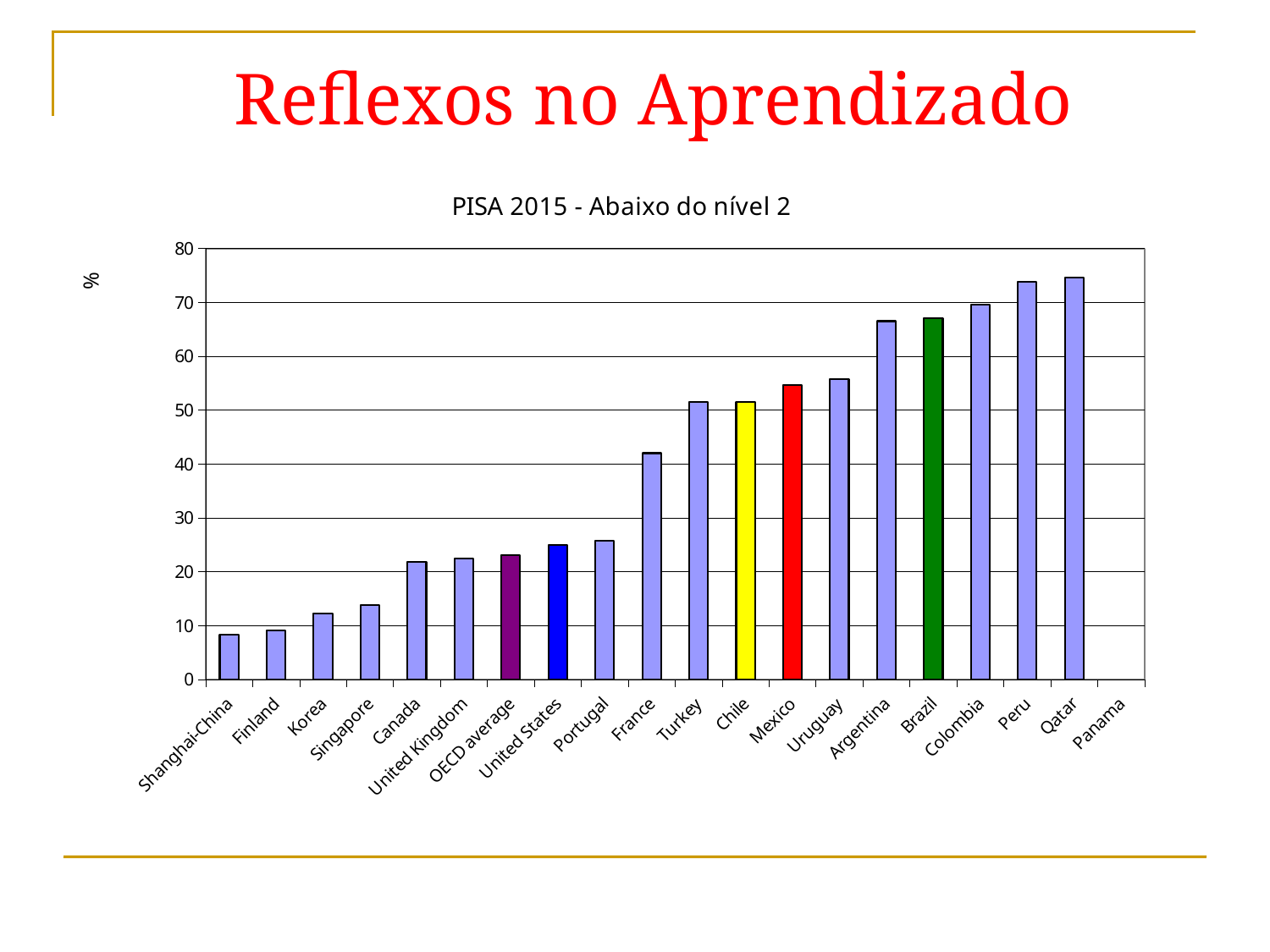
Which has the larger value, France or Turkey? Turkey Is the value for Qatar greater or less than 70? greater Is the value for France greater or less than 50? less Is the value for Portugal greater or less than 30? less Do the bar values generally rise or fall from left to right along the x axis? Rise How many categories are listed along the x axis of the chart? 20 What kind of chart is shown on the slide? Bar chart Which has the larger value, Brazil or United States? Brazil What is the title of the chart? PISA 2015 - Abaixo do nível 2 What label is shown on the vertical axis of the chart? %